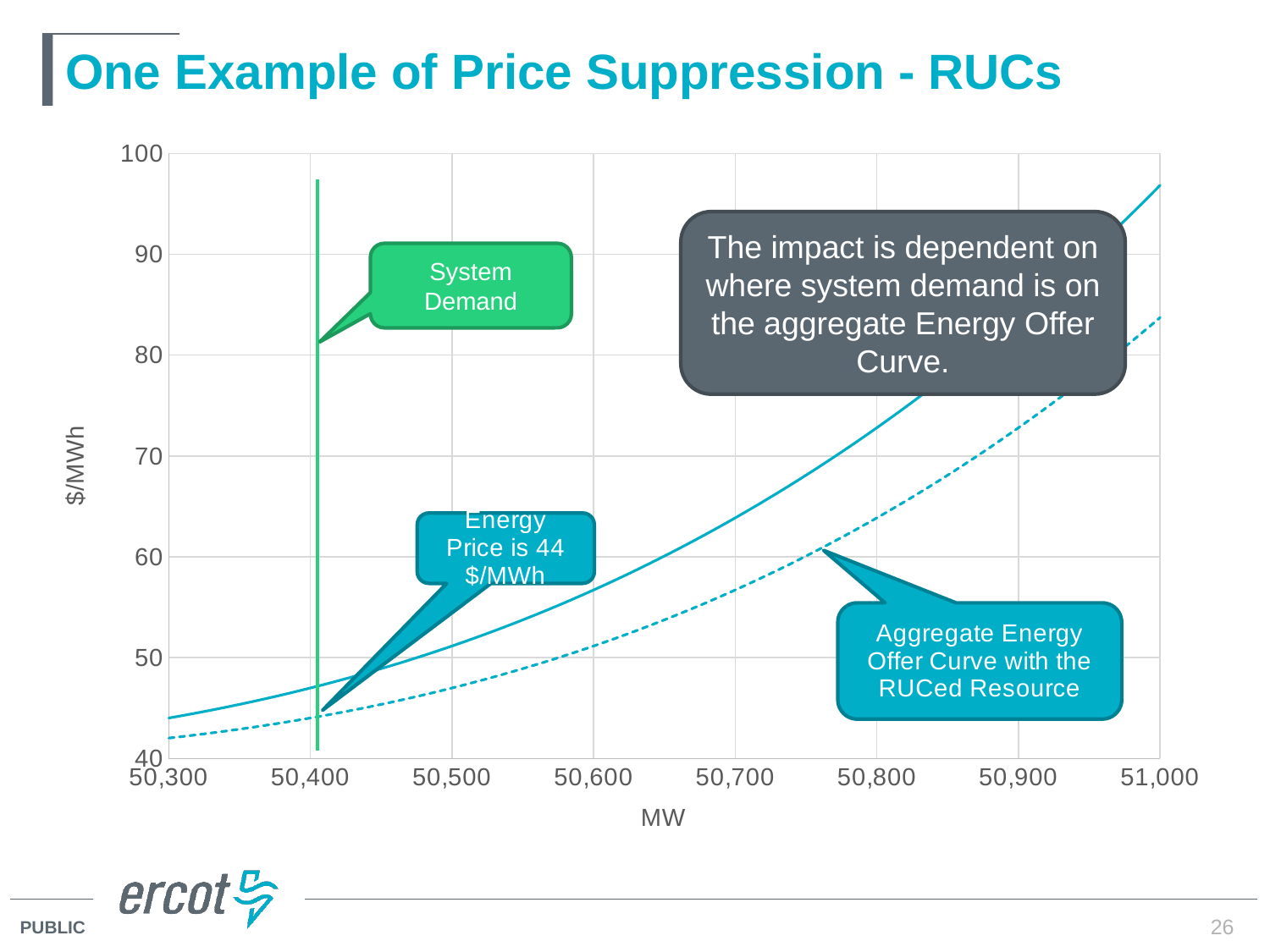
According to the callout on the chart, what is the energy price at the system demand level? 44 $/MWh Is the value of the solid curve at 51,000 MW greater or less than 90? greater Do the energy offer curves rise or fall as MW increases along the x axis? rise Is the value of the dashed Aggregate Energy Offer Curve with the RUCed Resource at 51,000 MW greater or less than 80? greater Is the value of the dashed curve at 50,300 MW greater or less than 50? less How many curves are plotted on the chart (excluding the vertical System Demand line)? 2 At 51,000 MW, which curve is higher: the solid curve or the dashed Aggregate Energy Offer Curve with the RUCed Resource? the solid curve What kind of chart is shown on the slide? line chart What is the title of the slide containing the chart? One Example of Price Suppression - RUCs What are the labels of the x axis and y axis of the chart? MW and $/MWh